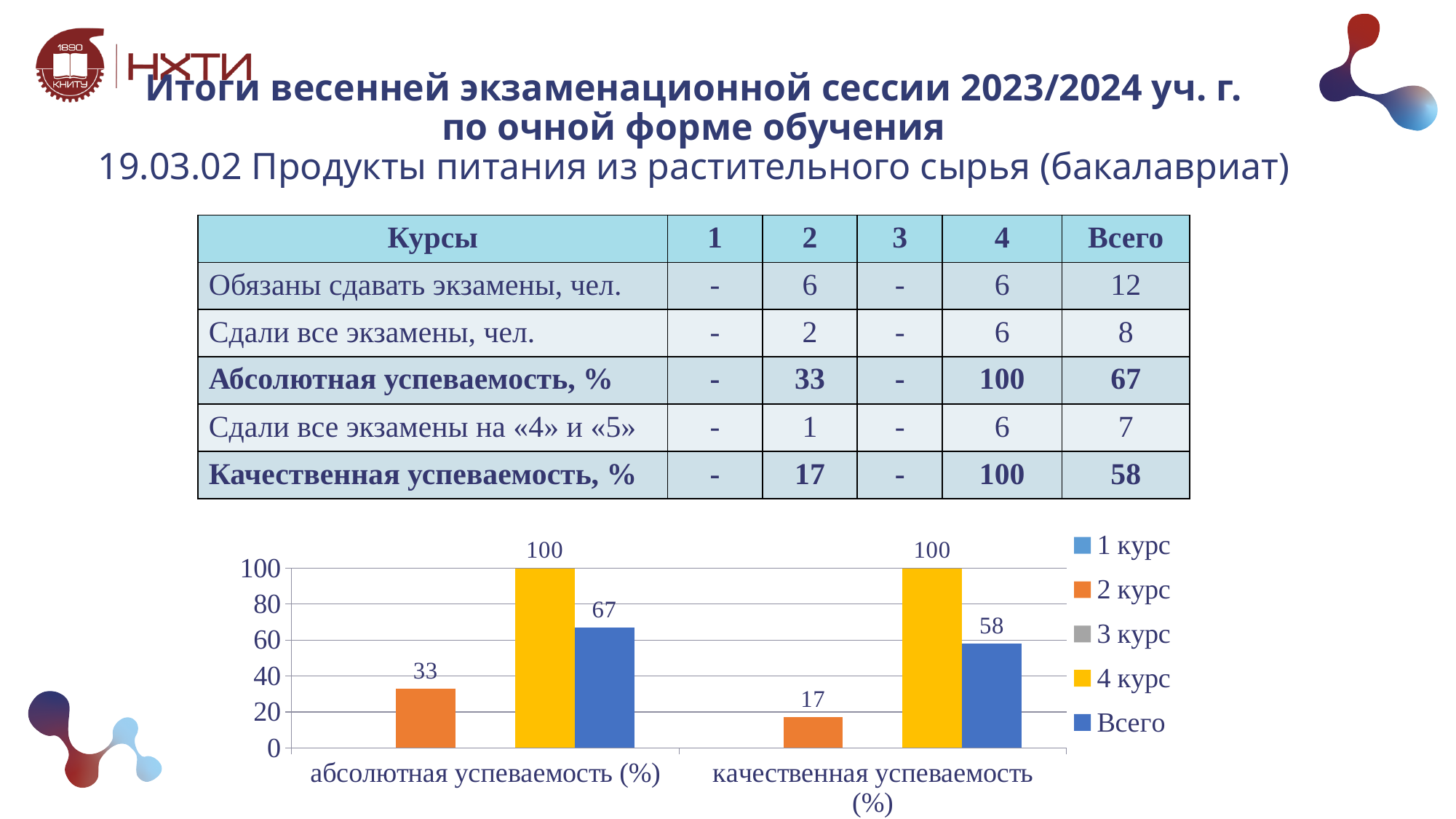
How many categories are shown on the x axis of the chart? 2 How many series does the chart legend list? 5 Which series has the lowest plotted value in the качественная успеваемость (%) category? 2 курс Which series has the highest value in the абсолютная успеваемость (%) category? 4 курс What is the value for 4 курс in the качественная успеваемость (%) category? 100 Which is larger: the 2 курс value for абсолютная успеваемость (%) or for качественная успеваемость (%)? абсолютная успеваемость (%) What is the value for Всего in the качественная успеваемость (%) category? 58 What is the value for 2 курс in the абсолютная успеваемость (%) category? 33 What is the value for Всего in the абсолютная успеваемость (%) category? 67 What type of chart is shown on the slide? bar chart Which legend entry is shown in yellow? 4 курс What is the difference between the Всего values for абсолютная успеваемость (%) and качественная успеваемость (%)? 9